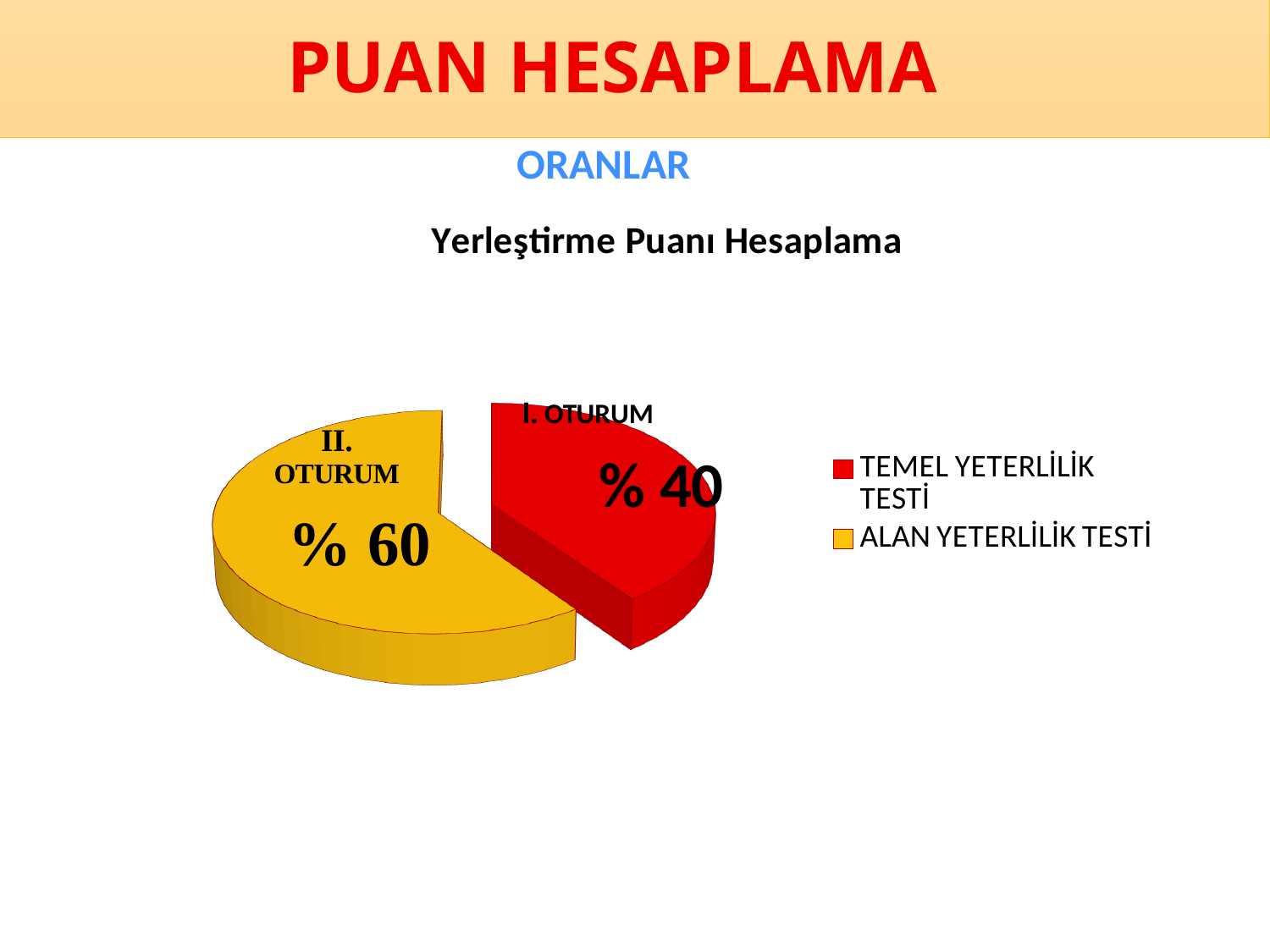
How many entries does the legend list? 2 What colour is the slice for TEMEL YETERLİLİK TESTİ? red What share of the pie does TEMEL YETERLİLİK TESTİ (I. OTURUM) have? % 40 Which is larger: the share for I. OTURUM or the share for II. OTURUM? II. OTURUM What share of the pie does ALAN YETERLİLİK TESTİ (II. OTURUM) have? % 60 Which slice is the largest in the pie chart? ALAN YETERLİLİK TESTİ How many slices does the pie chart have? 2 What is the difference between the II. OTURUM share and the I. OTURUM share? 20 percentage points What kind of chart is shown on the slide? pie chart Which slice is the smallest in the pie chart? TEMEL YETERLİLİK TESTİ What is the title shown above the pie chart? Yerleştirme Puanı Hesaplama